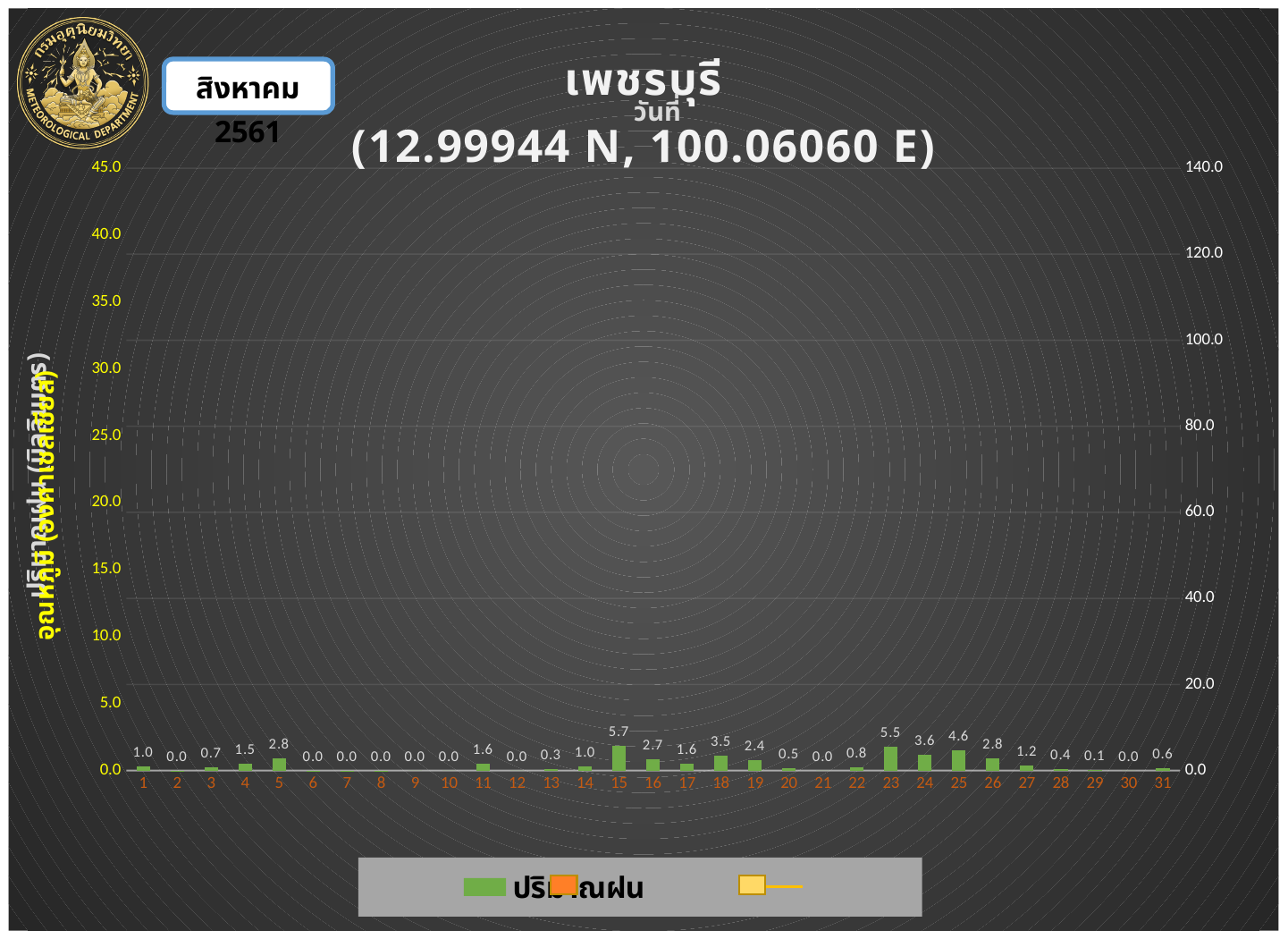
How many days are shown on the x axis of the chart? 31 What is the difference between the rainfall values for day 25 and day 24? 1.0 What is the difference between the rainfall values for day 15 and day 23? 0.2 What is the rainfall value shown for day 15? 5.7 Which day has the highest rainfall value? 15 What kind of chart is used to show the rainfall values? bar chart What is the rainfall value shown for day 25? 4.6 Which has a larger rainfall value, day 11 or day 26? day 26 What is the rainfall value shown for day 5? 2.8 Which has a larger rainfall value, day 18 or day 19? day 18 What is the highest tick value shown on the left y axis? 45.0 What is the rainfall value shown for day 23? 5.5